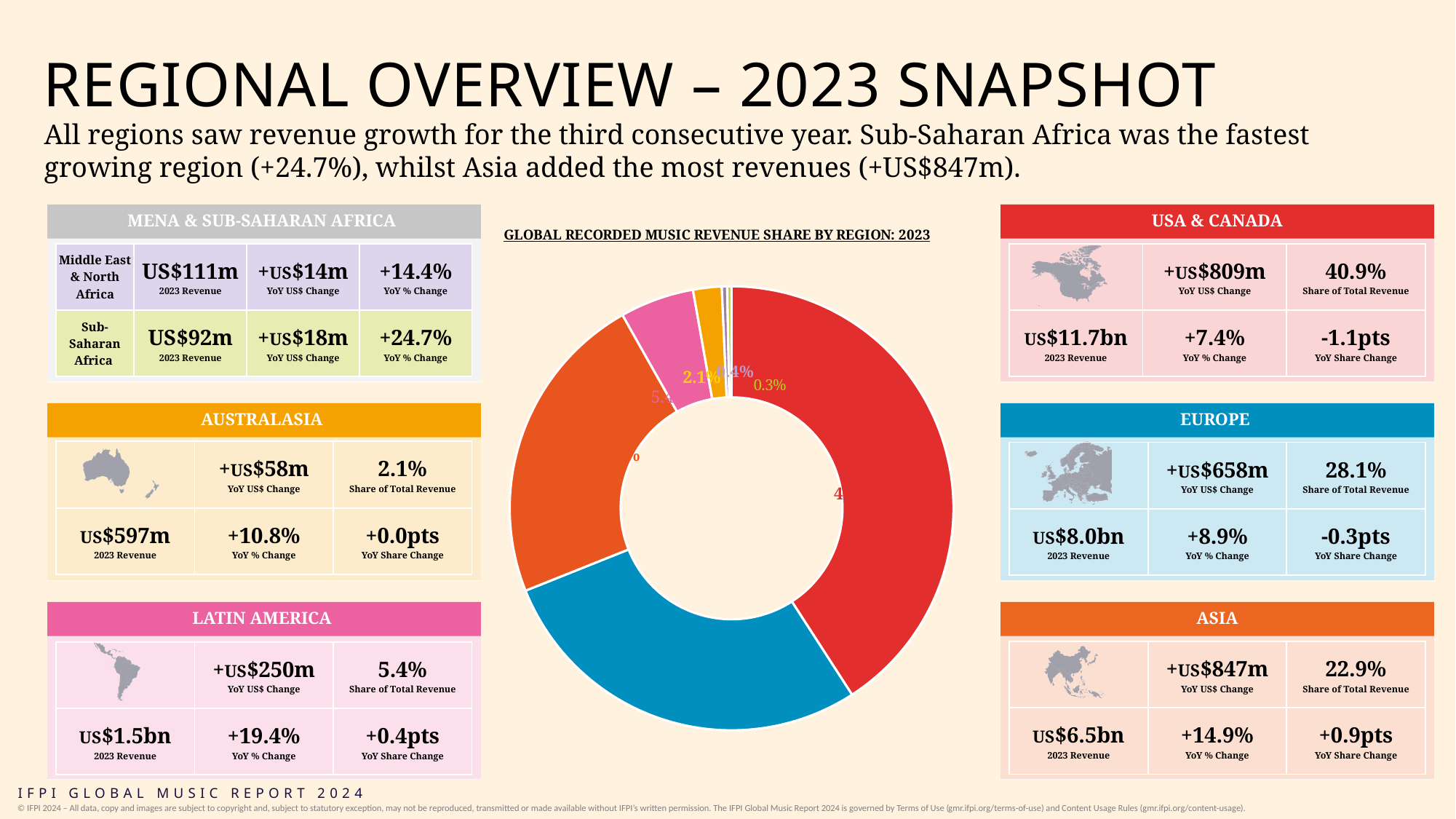
What kind of chart is shown under the title 'GLOBAL RECORDED MUSIC REVENUE SHARE BY REGION: 2023'? Pie (donut) chart Which region has the smallest slice of the donut chart? Sub-Saharan Africa What share of total revenue does the Asia slice represent? 22.9% What share of total revenue does the blue slice (Europe) represent? 28.1% What is the difference in share of total revenue between USA & Canada and Europe? 12.8 percentage points What is the title of the chart in the centre of the slide? GLOBAL RECORDED MUSIC REVENUE SHARE BY REGION: 2023 What colour is the largest slice of the donut chart? Red What share is labelled on the Australasia slice of the donut chart? 2.1% What share of total revenue does the red slice (USA & Canada) represent? 40.9% Which slice is larger in the donut chart: Europe or Asia? Europe How many slices does the donut chart contain? 7 Which region has the largest slice of the donut chart? USA & Canada